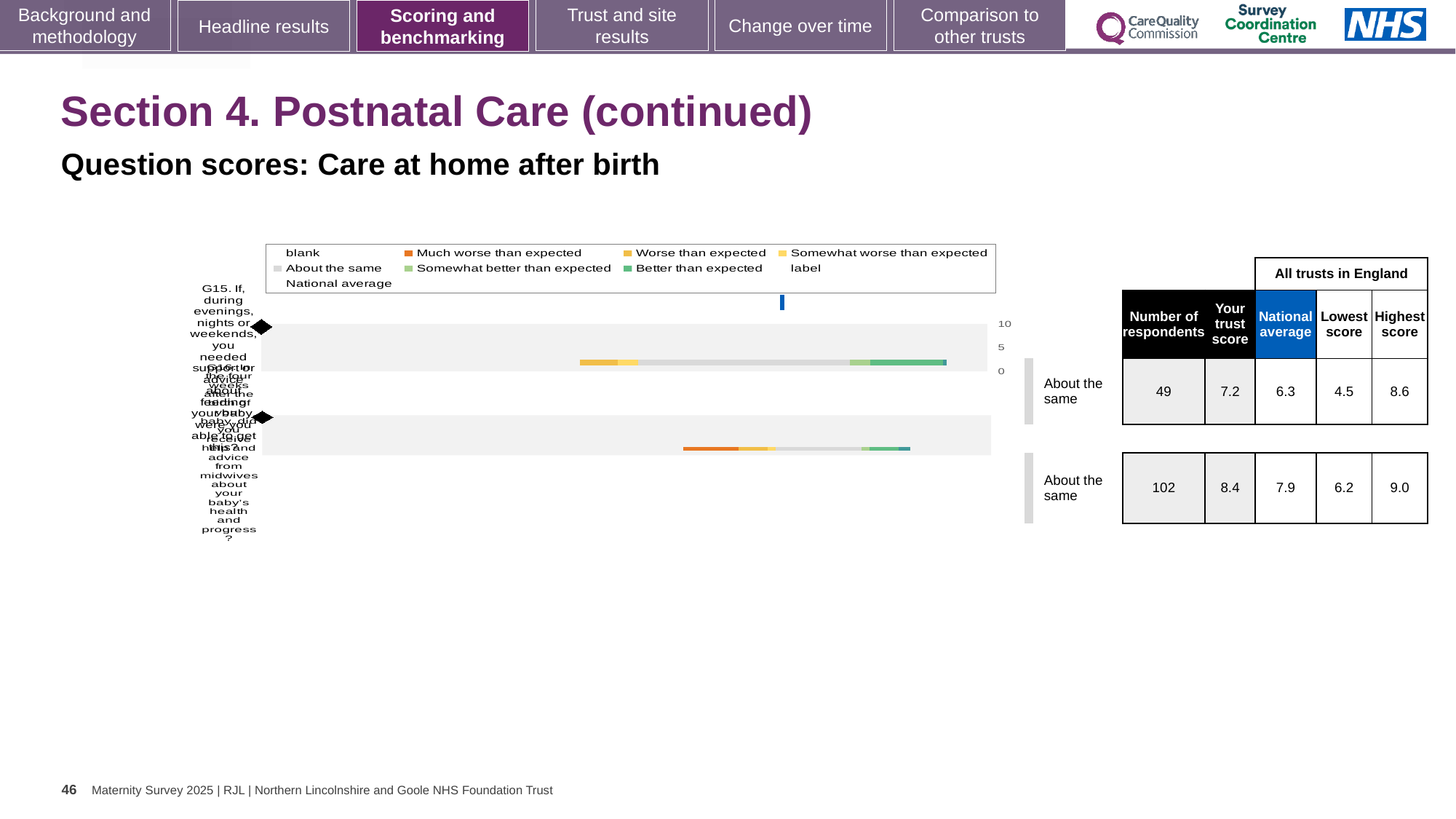
What kind of chart is shown on the slide? bar chart For the first (top) question row, what is the difference between the highest score and the lowest score? 4.1 For the second (bottom) question row, how much higher is the trust score than the national average? 0.5 In the table next to the chart, what is the national average for the second (bottom) question row? 7.9 For the first (top) question row, which is larger: the trust score or the national average? the trust score (7.2) What benchmark category is shown for both question rows? About the same In the table next to the chart, what is the number of respondents for the first (top) question row? 49 In the table next to the chart, what is the highest score for the second (bottom) question row? 9.0 What colour does the legend use for 'Much worse than expected'? orange Which question row has the larger number of respondents? the second (bottom) row, with 102 In the table next to the chart, what is the trust score for the first (top) question row? 7.2 How many question bars are plotted in the chart? 2